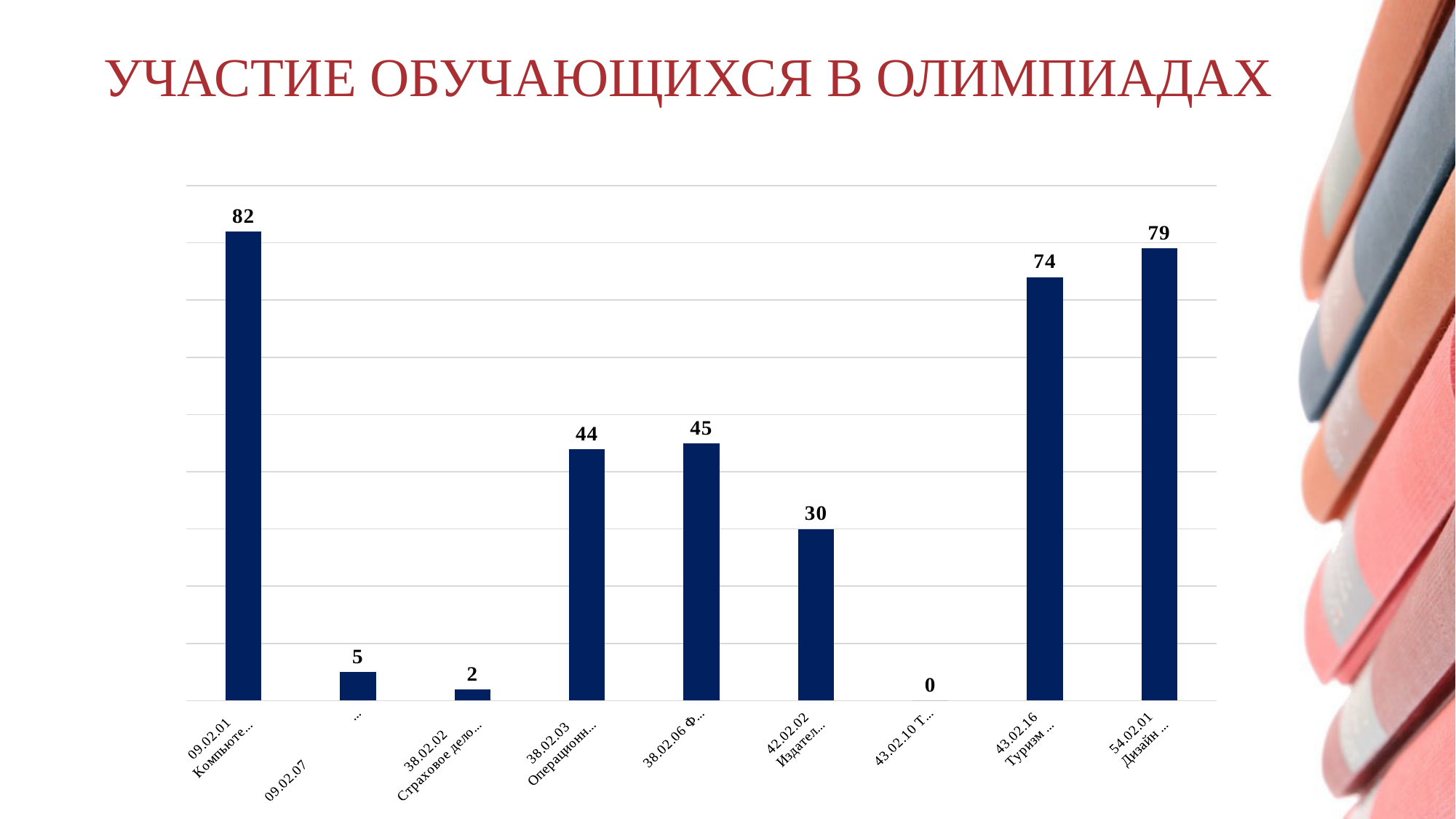
What is the value for the category 42.02.02? 30 What kind of chart is shown on the slide? bar chart What is the value for the category 43.02.16 (Туризм)? 74 What is the value for the category 43.02.10? 0 What is the difference between the values for 09.02.07 and 38.02.02? 3 Which category has the highest value? 09.02.01 Which is larger, the value for 38.02.03 or the value for 42.02.02? 38.02.03 What is the value for the category 09.02.01? 82 How many categories (bars) are shown in the chart? 9 Which category has the lowest value? 43.02.10 What is the title of the chart slide? УЧАСТИЕ ОБУЧАЮЩИХСЯ В ОЛИМПИАДАХ What is the difference between the values for 09.02.01 and 54.02.01 (Дизайн)? 3